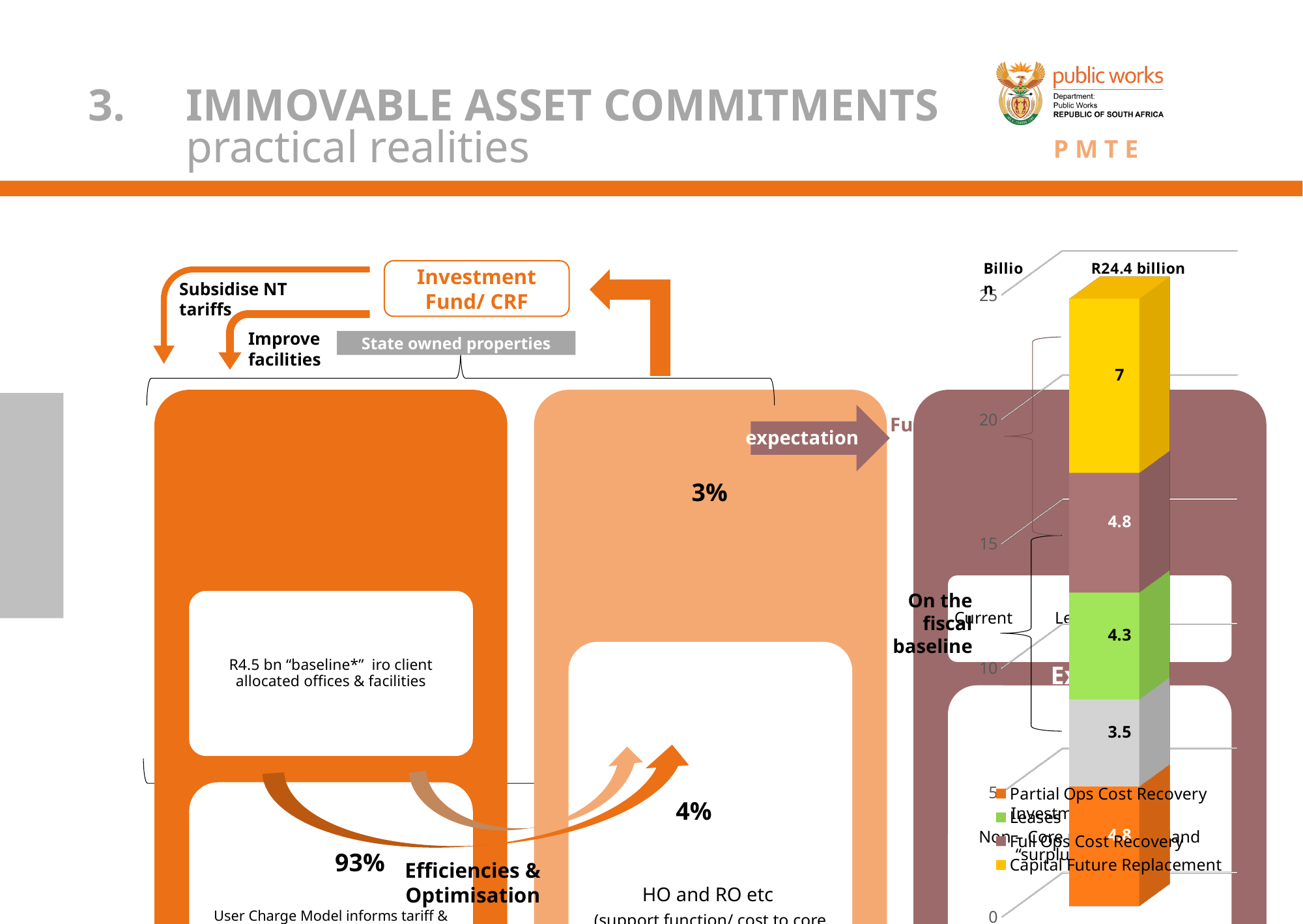
In the stacked bar chart, which segment has the largest value? Capital Future Replacement What is the title of the stacked bar chart on the right of the slide? R24.4 billion In the stacked bar chart, what is the value of the green Leases segment? 4.3 What is the total of all segments in the stacked bar chart? 24.4 What kind of chart is shown on the right side of the slide? stacked bar chart In the stacked bar chart, what is the value of the brown Full Ops Cost Recovery segment? 4.8 In the stacked bar chart, what is the difference between the Capital Future Replacement segment and the Leases segment? 2.7 In the stacked bar chart, what is the value of the yellow Capital Future Replacement segment? 7 How many segments make up the stacked bar in the chart on the right? 5 In the stacked bar chart, what is the smallest segment value? 3.5 In the stacked bar chart, which is larger: the Capital Future Replacement segment or the Full Ops Cost Recovery segment? Capital Future Replacement In the stacked bar chart, what is the value of the grey segment? 3.5